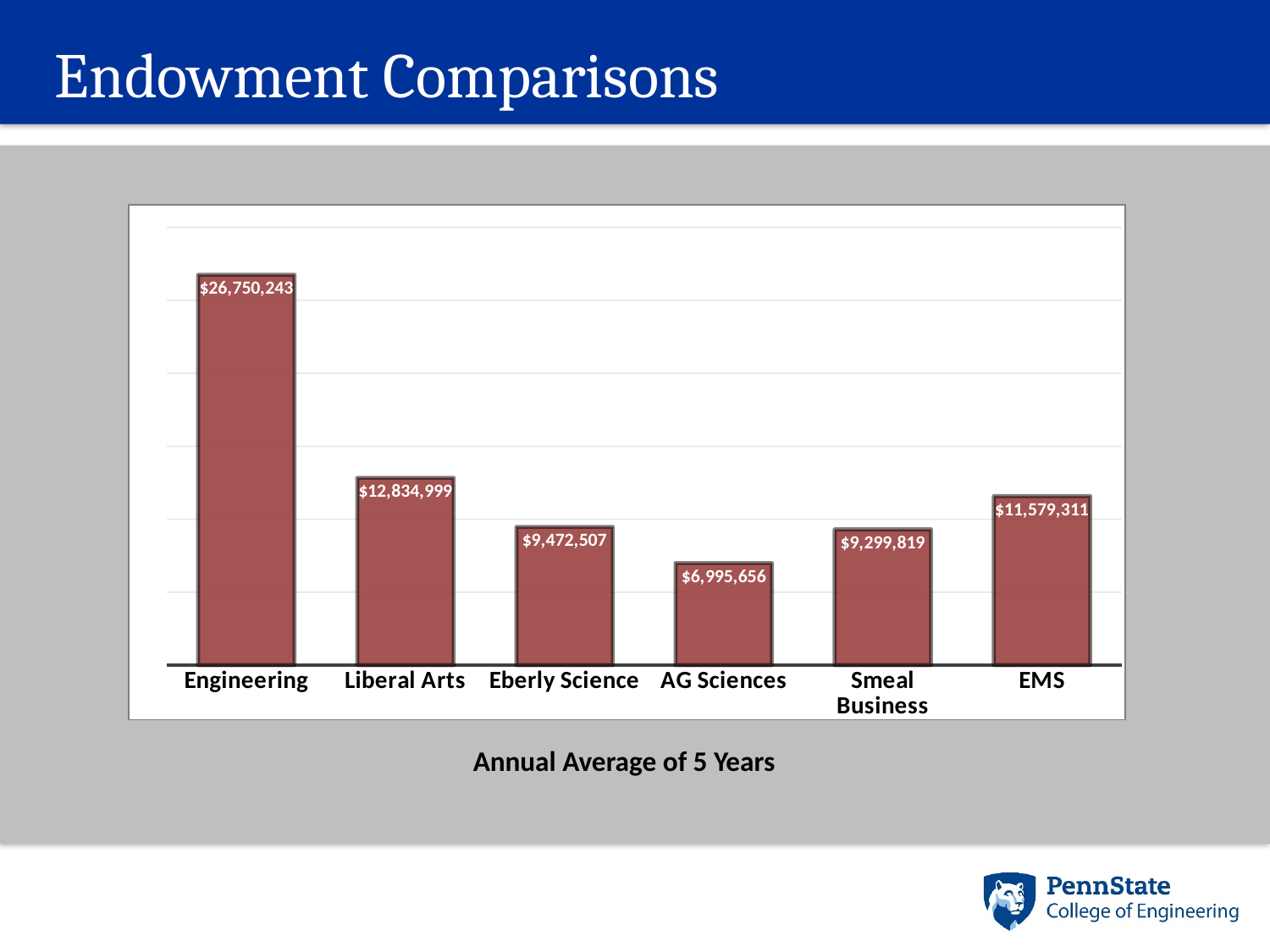
What is the value for Engineering? $26,750,243 How many categories are shown on the chart? 6 What caption appears below the chart? Annual Average of 5 Years What is the difference between the values for Liberal Arts and EMS? $1,255,688 Which category has the lowest value? AG Sciences Which category has the highest value? Engineering What is the value for EMS? $11,579,311 Which is larger, the value for Eberly Science or the value for Smeal Business? Eberly Science What is the value for Smeal Business? $9,299,819 What is the difference between the values for Engineering and Liberal Arts? $13,915,244 What is the value for AG Sciences? $6,995,656 What kind of chart is shown on the slide? Bar chart